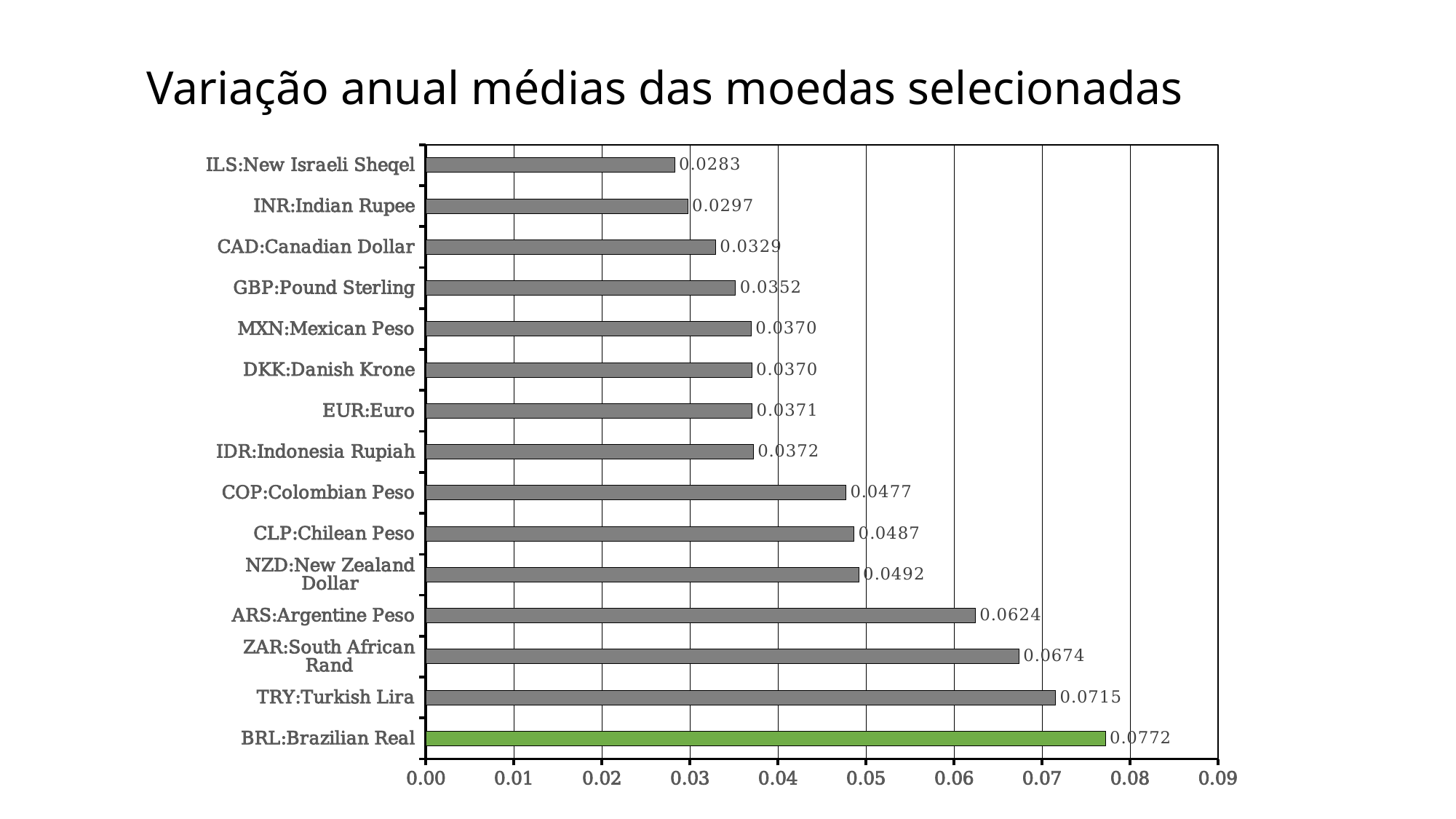
What is the value for TRY:Turkish Lira? 0.0715 Is the value for ARS:Argentine Peso greater or less than 0.06? greater What is the difference between the values for ZAR:South African Rand and ARS:Argentine Peso? 0.0050 Which is larger, the value for NZD:New Zealand Dollar or the value for GBP:Pound Sterling? NZD:New Zealand Dollar What kind of chart is shown on the slide? bar chart What is the value for COP:Colombian Peso? 0.0477 What is the difference between the values for BRL:Brazilian Real and TRY:Turkish Lira? 0.0057 How many currencies are shown in the chart? 15 Which currency has the highest value? BRL:Brazilian Real Which bar is coloured green rather than grey? BRL:Brazilian Real What is the value for CAD:Canadian Dollar? 0.0329 Which currency has the lowest value? ILS:New Israeli Sheqel